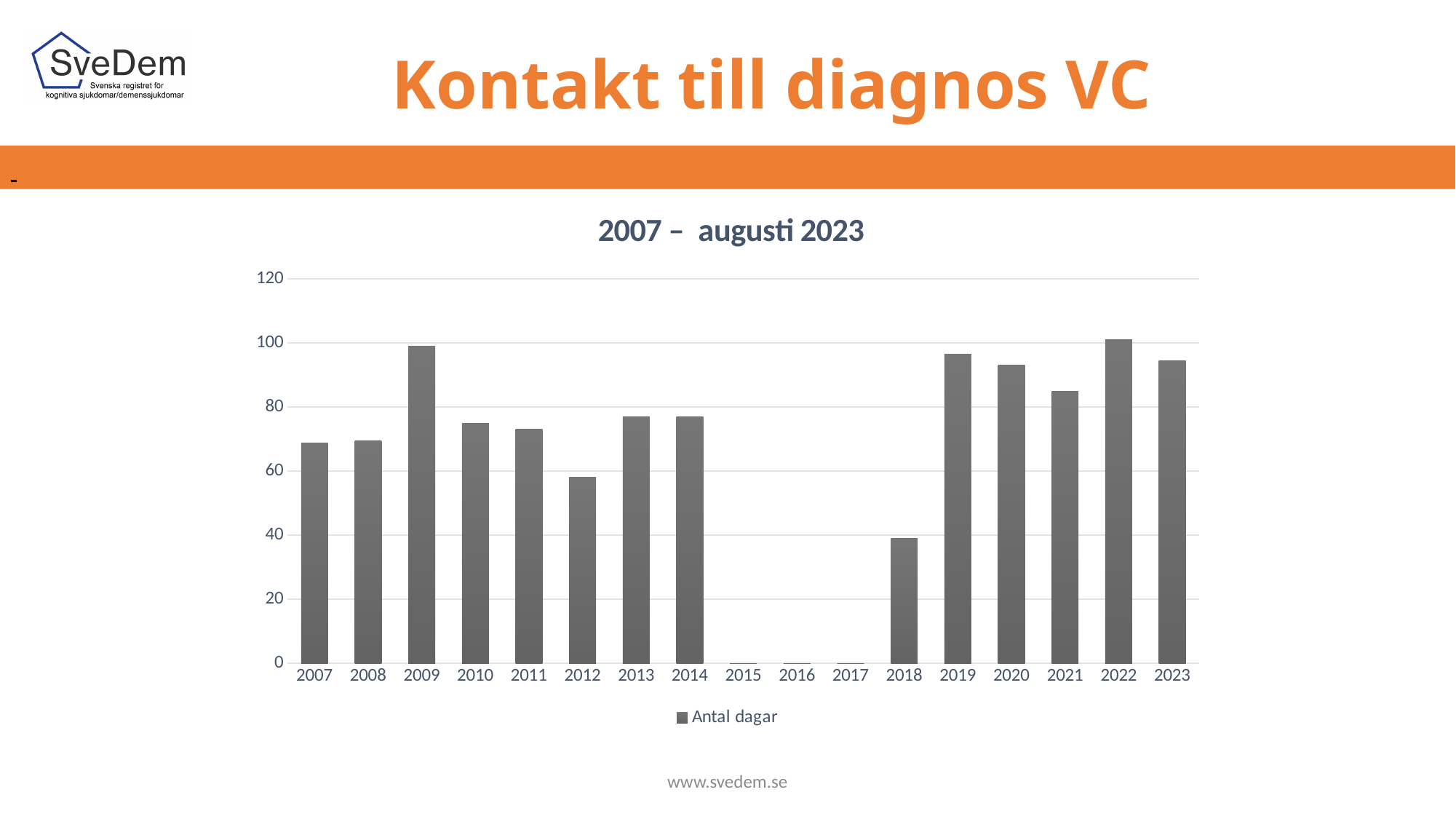
What is the title of the chart? 2007 – augusti 2023 Do the values rise or fall from 2009 to 2012? fall What kind of chart is shown on the slide? bar chart How many series does the legend list? 1 Is the value for 2007 greater or less than 60? greater Is the value for 2018 greater or less than 60? less Which year has a higher value, 2018 or 2019? 2019 Is the value for 2020 greater or less than 80? greater What series name does the legend show? Antal dagar How many years are shown on the x axis? 17 Which year has a higher value, 2009 or 2012? 2009